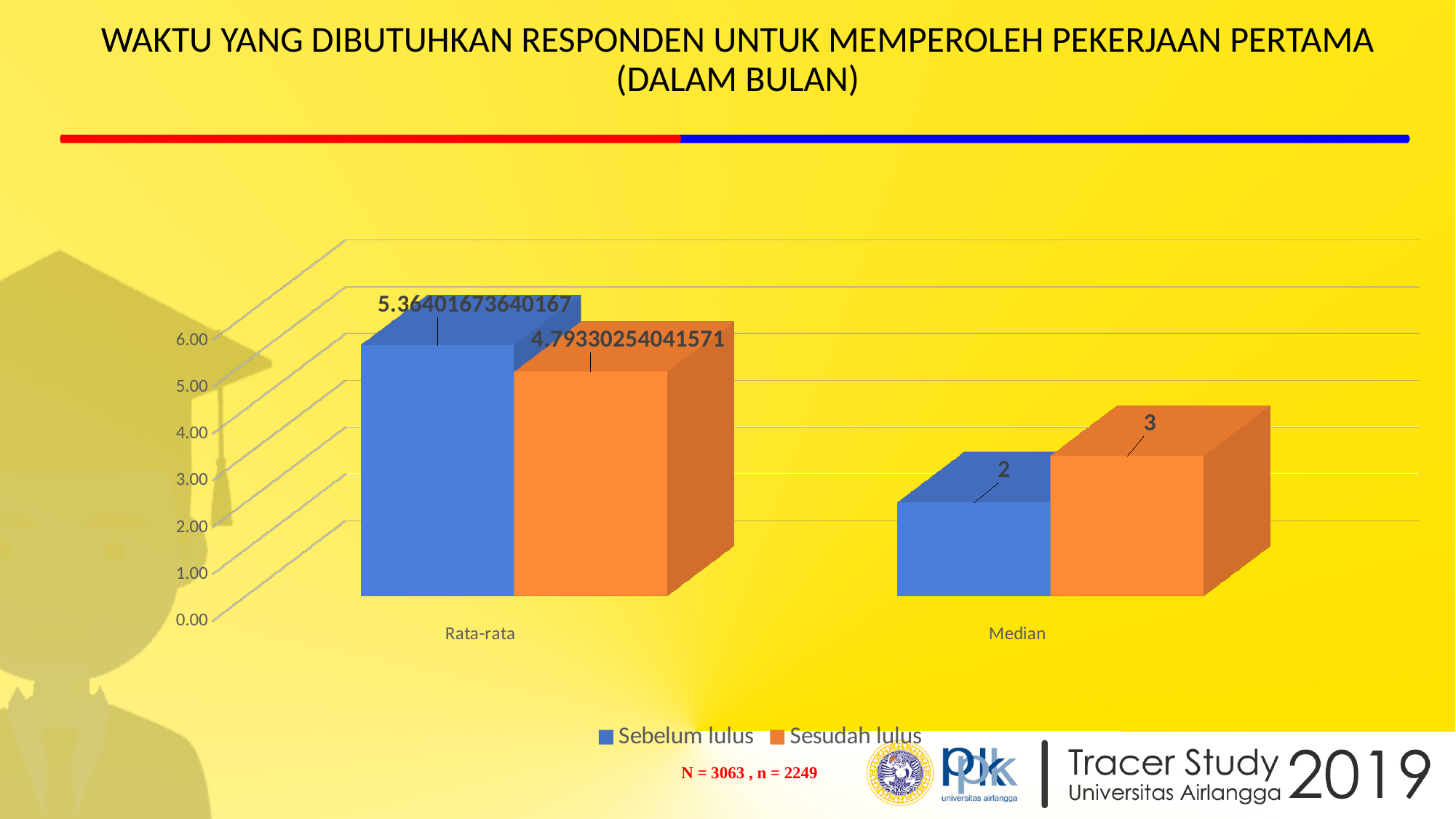
What kind of chart is shown on the slide? Bar chart Which bar in the chart has the highest value? Sebelum lulus, Rata-rata Which series has the higher value in the Rata-rata category? Sebelum lulus How many series does the legend list? 2 What is the value for Sebelum lulus in the Median category? 2 What is the value for Sesudah lulus in the Median category? 3 Which bar in the chart has the lowest value? Sebelum lulus, Median What is the value for Sesudah lulus in the Rata-rata category? 4.79330254041571 How many categories are shown on the x axis? 2 What is the value for Sebelum lulus in the Rata-rata category? 5.36401673640167 Which series has the higher value in the Median category? Sesudah lulus What is the difference between the Sesudah lulus and Sebelum lulus values in the Median category? 1